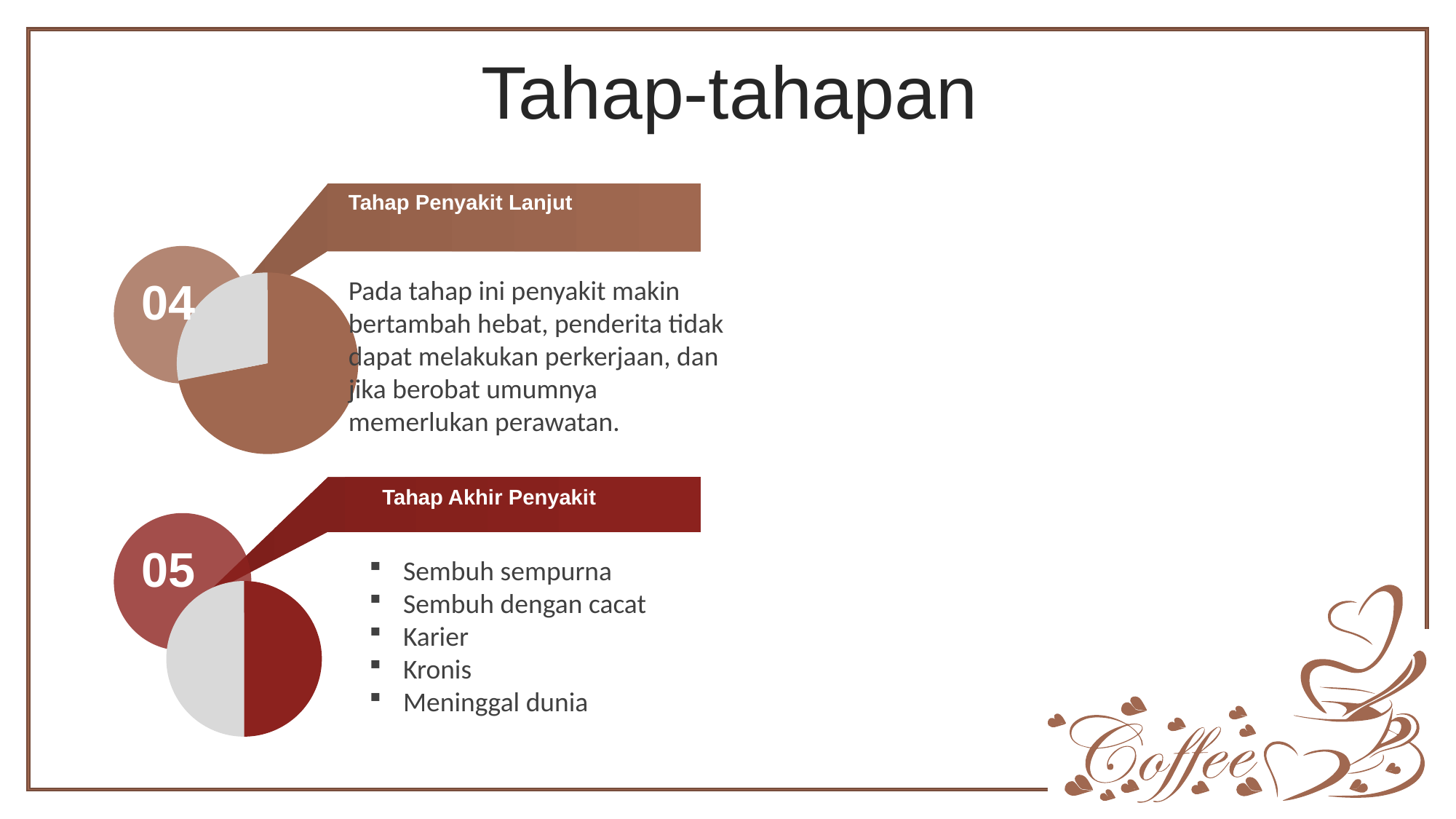
In the pie chart next to the number 04, is the grey slice's share greater or less than 50%? less What kind of chart is shown next to the number 04? pie chart How many slices does the pie chart next to the number 05 have? 2 How many slices does the pie chart next to the number 04 have? 2 What colour is the non-grey slice in the pie chart next to the number 05? dark red In the pie chart next to the number 04, which slice is larger, the brown slice or the grey slice? the brown slice Does either pie chart on the slide show a legend? No In the pie chart next to the number 04, is the brown slice's share greater or less than 50%? greater What kind of chart is shown next to the number 05? pie chart